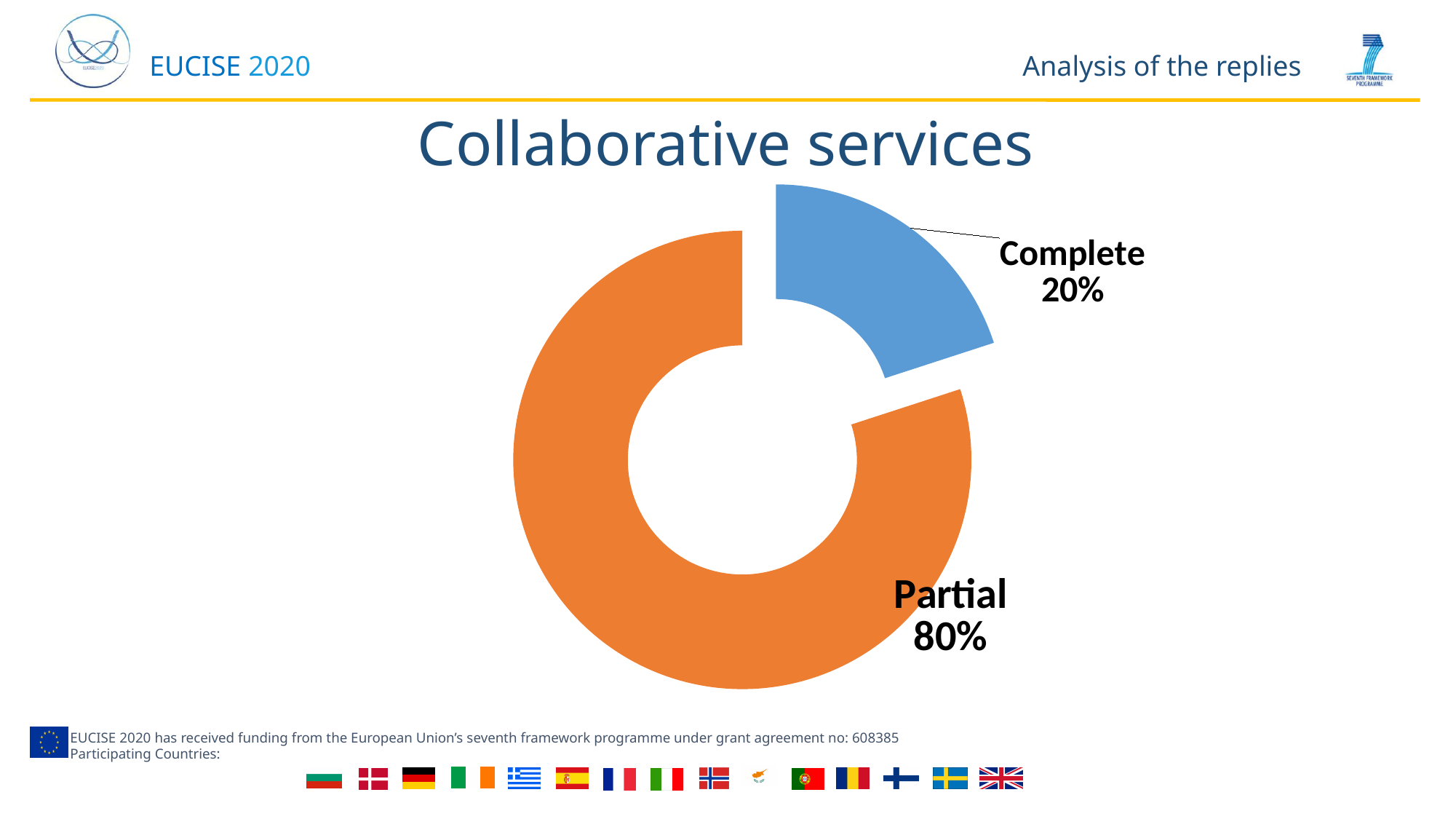
What colour is the Partial segment of the chart? Orange Which category has the largest share in the Collaborative services chart? Partial What share of the chart does the Complete slice represent? 20% Which is larger, the Partial share or the Complete share? Partial What percentage of replies for Collaborative services are Partial? 80% What kind of chart is shown on the slide? Doughnut (pie) chart What is the title of the chart on the slide? Collaborative services Which category has the smallest share in the Collaborative services chart? Complete How many categories are shown in the Collaborative services chart? 2 What percentage of replies for Collaborative services are Complete? 20% What is the difference in percentage points between the Partial and Complete shares? 60 percentage points